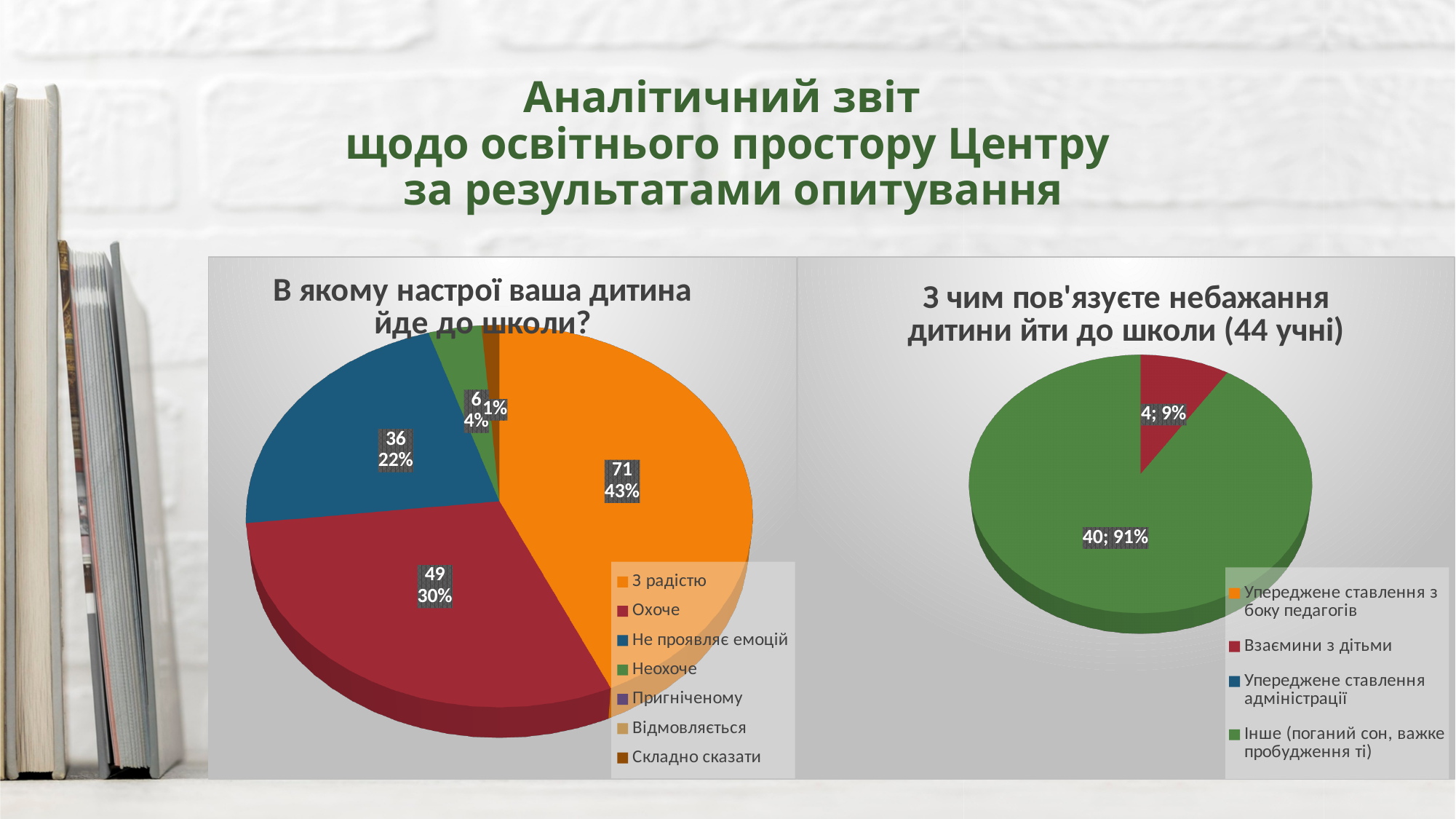
In the left chart 'В якому настрої ваша дитина йде до школи?', which category has the largest slice? З радістю What type of chart is the right chart 'З чим пов'язуєте небажання дитини йти до школи (44 учні)'? Pie chart In the left chart 'В якому настрої ваша дитина йде до школи?', what value is shown for 'Не проявляє емоцій'? 36 How many entries does the legend of the left chart 'В якому настрої ваша дитина йде до школи?' list? 7 In the right chart 'З чим пов'язуєте небажання дитини йти до школи (44 учні)', what is the total of the two labelled slice values? 44 In the right chart 'З чим пов'язуєте небажання дитини йти до школи (44 учні)', what share is shown for 'Інше (поганий сон, важке пробудження ті)'? 91% In the left chart 'В якому настрої ваша дитина йде до школи?', which is larger: 'Охоче' or 'Не проявляє емоцій'? Охоче In the left chart 'В якому настрої ваша дитина йде до школи?', what percentage is shown for 'Неохоче'? 4% In the right chart 'З чим пов'язуєте небажання дитини йти до школи (44 учні)', what value is shown for 'Взаємини з дітьми'? 4 In the left chart 'В якому настрої ваша дитина йде до школи?', what value is shown for 'З радістю'? 71 In the left chart 'В якому настрої ваша дитина йде до школи?', what percentage is shown for 'Охоче'? 30% In the left chart 'В якому настрої ваша дитина йде до школи?', what is the difference between the values for 'З радістю' and 'Охоче'? 22